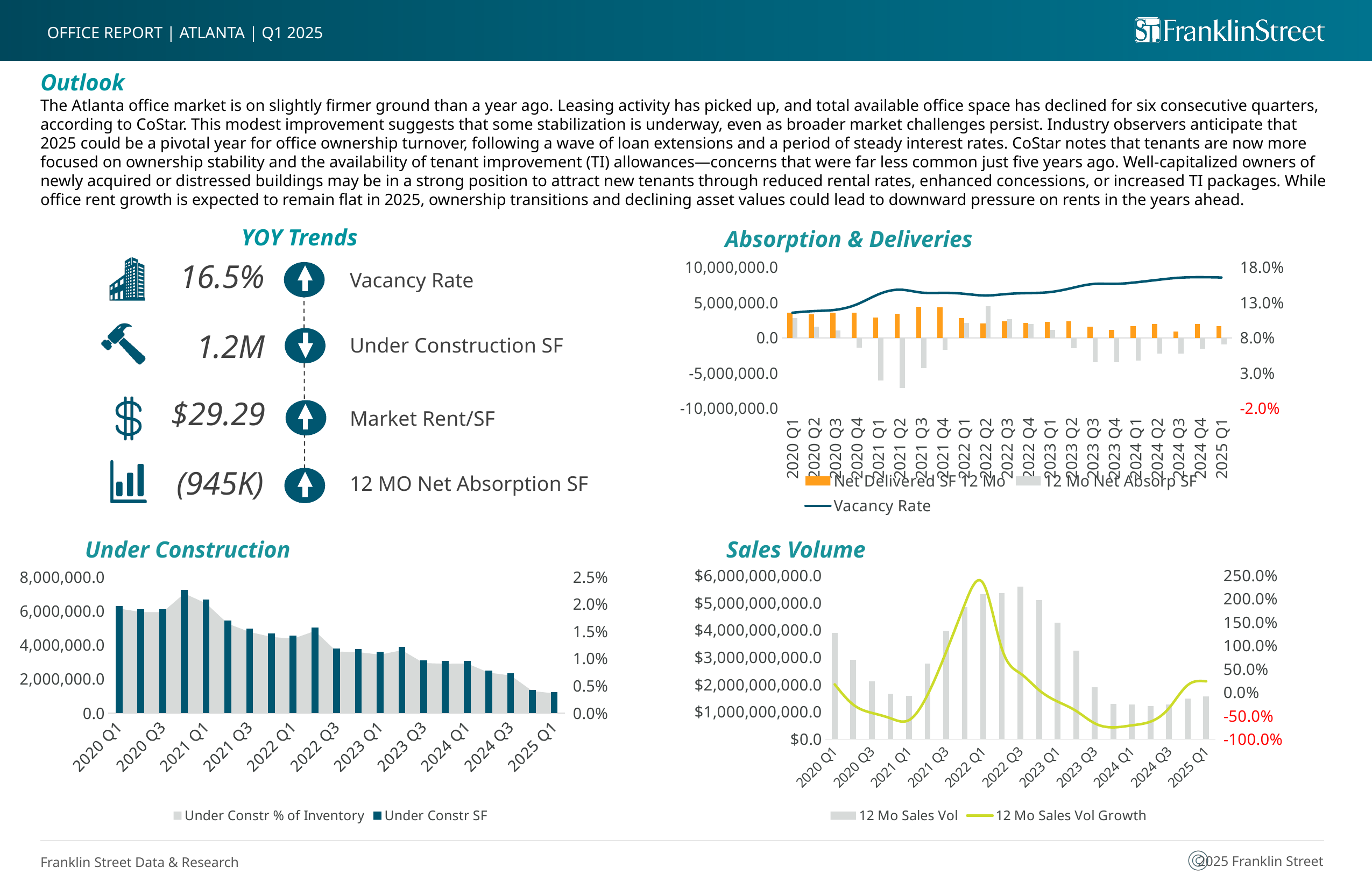
In the Absorption & Deliveries chart, what are the three legend entries? Net Delivered SF 12 Mo, 12 Mo Net Absorp SF, Vacancy Rate In the Under Construction chart, does Under Constr SF generally rise or fall from 2021 Q1 to 2025 Q1? fall In the Absorption & Deliveries chart, is the 12 Mo Net Absorp SF value for 2021 Q2 greater or less than -5,000,000.0? less In the Under Construction chart, which quarter has the highest Under Constr SF? 2020 Q4 In the Sales Volume chart, is the 12 Mo Sales Vol Growth for 2022 Q1 greater or less than 200.0%? greater In the Absorption & Deliveries chart, does the Vacancy Rate line generally rise or fall from 2020 Q1 to 2025 Q1? rise In the Absorption & Deliveries chart, how many series does the legend list? 3 In the Sales Volume chart, is the 12 Mo Sales Vol for 2022 Q3 greater or less than $5,000,000,000.0? greater In the Sales Volume chart, what kind of chart is shown? combination bar and line chart In the Under Construction chart, how many series does the legend list? 2